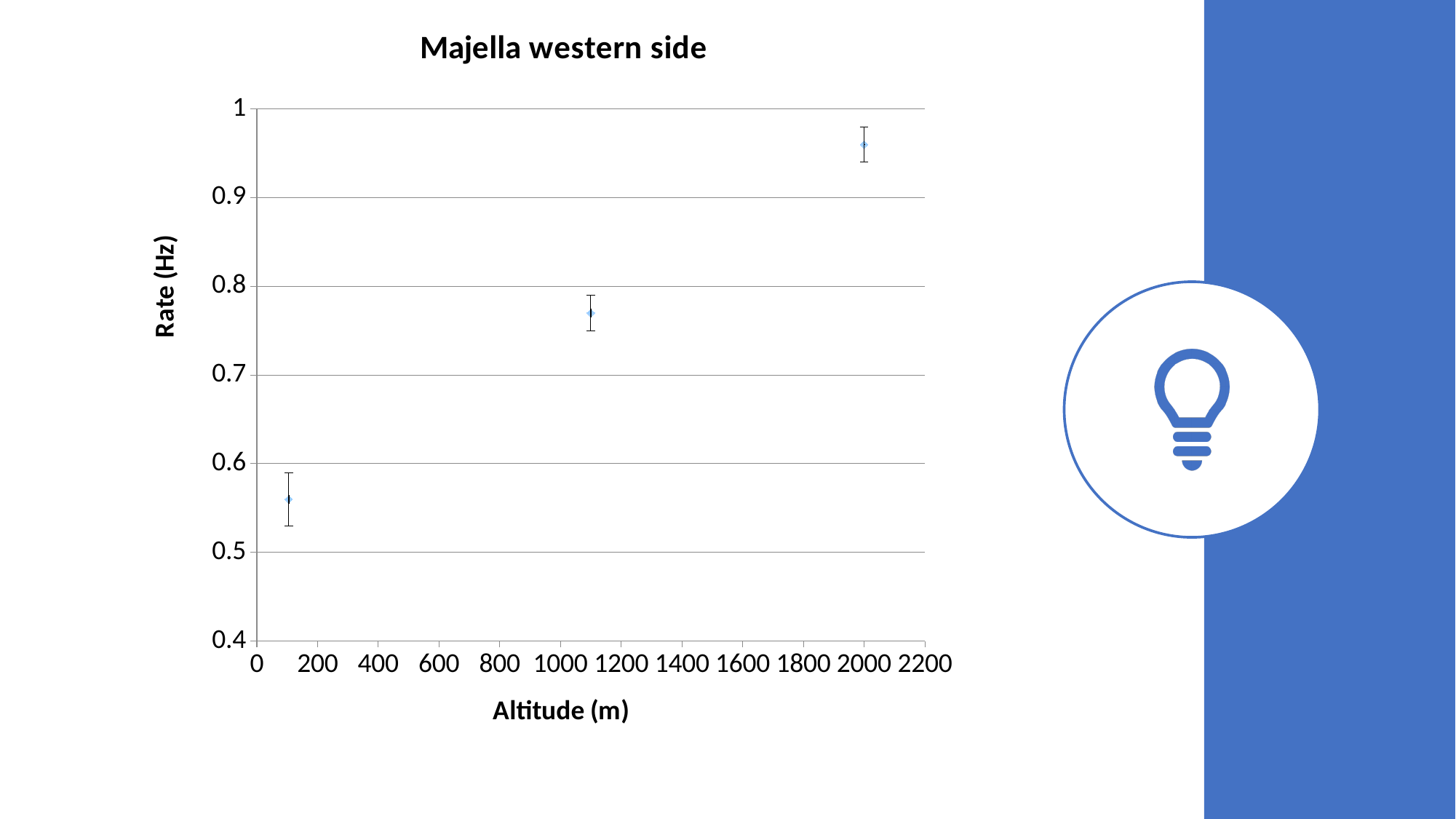
Is the rate for the rightmost data point greater or less than 0.9? greater Which data point has the lowest rate: the leftmost, the middle, or the rightmost? leftmost Is the rate for the leftmost data point greater or less than 0.6? less What type of chart is shown on the slide? scatter chart Which has the larger rate: the middle data point or the rightmost data point? rightmost What is the label of the y axis? Rate (Hz) Do the rate values rise or fall as altitude increases along the x axis? rise Is the rate for the middle data point greater or less than 0.8? less How many data points are plotted in the chart? 3 What is the title of the chart? Majella western side Which data point has the highest rate: the leftmost, the middle, or the rightmost? rightmost